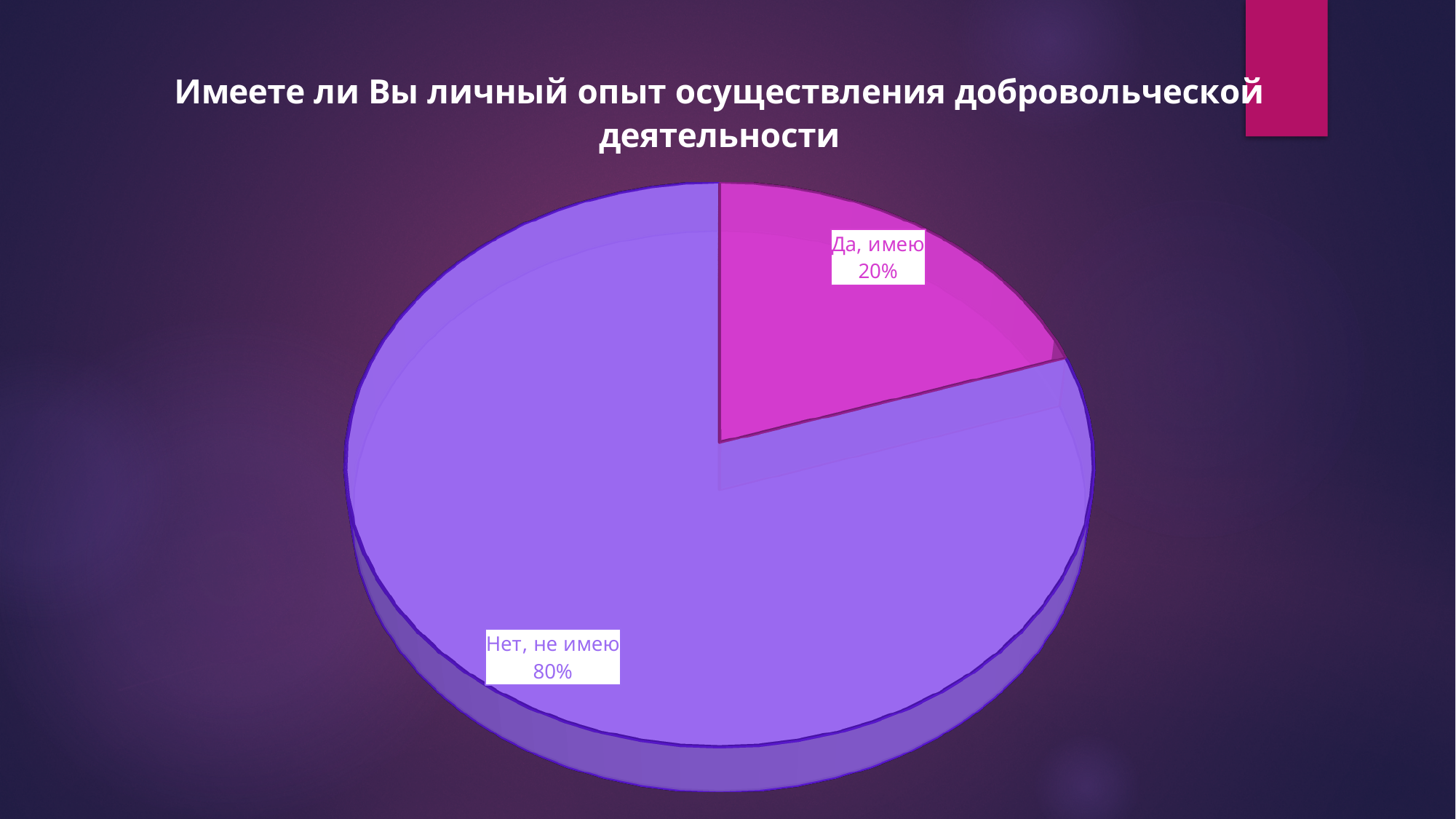
What kind of chart is shown on the slide? Pie chart How many categories are shown in the pie chart? 2 What colour is the slice for "Да, имею"? Magenta (pink) Which category has the largest slice of the pie? Нет, не имею Which is larger: the share for "Да, имею" or the share for "Нет, не имею"? Нет, не имею What is the difference in percentage points between "Нет, не имею" and "Да, имею"? 60 percentage points What share of the pie does "Да, имею" represent? 20% Which category has the smallest slice of the pie? Да, имею What is the title of the chart? Имеете ли Вы личный опыт осуществления добровольческой деятельности What share of the pie does "Нет, не имею" represent? 80%